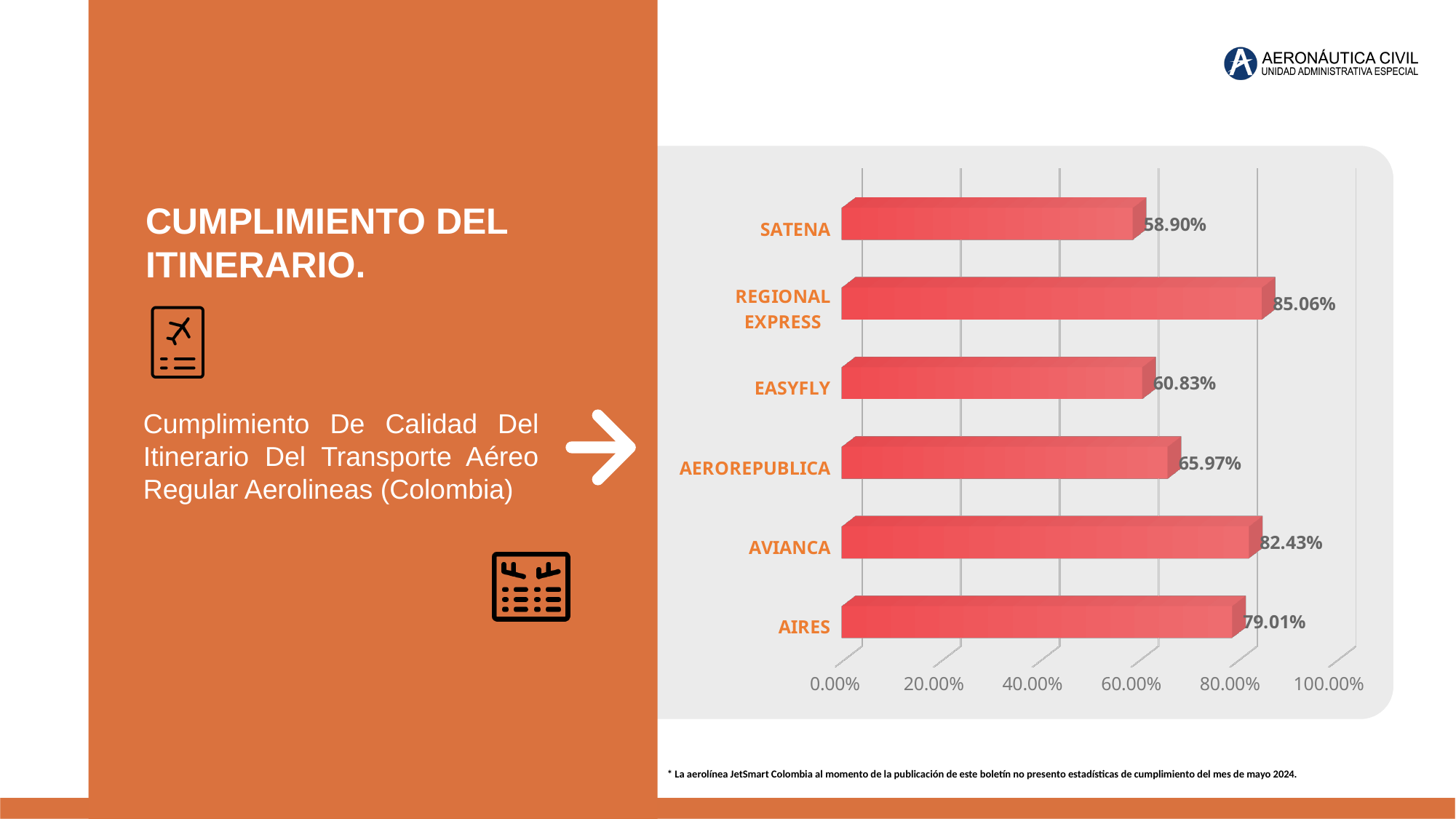
What is the difference between the values for REGIONAL EXPRESS and AVIANCA? 2.63% What is the value for AEROREPUBLICA? 65.97% What is the value for SATENA? 58.90% What is the difference between the values for EASYFLY and SATENA? 1.93% Is the value for AVIANCA greater or less than 80.00%? greater Which is larger, the value for EASYFLY or the value for AEROREPUBLICA? AEROREPUBLICA Which airline has the highest value? REGIONAL EXPRESS What is the value for REGIONAL EXPRESS? 85.06% What kind of chart is shown on the slide? bar chart Which airline has the lowest value? SATENA What is the value for AIRES? 79.01% How many airlines are shown in the chart? 6